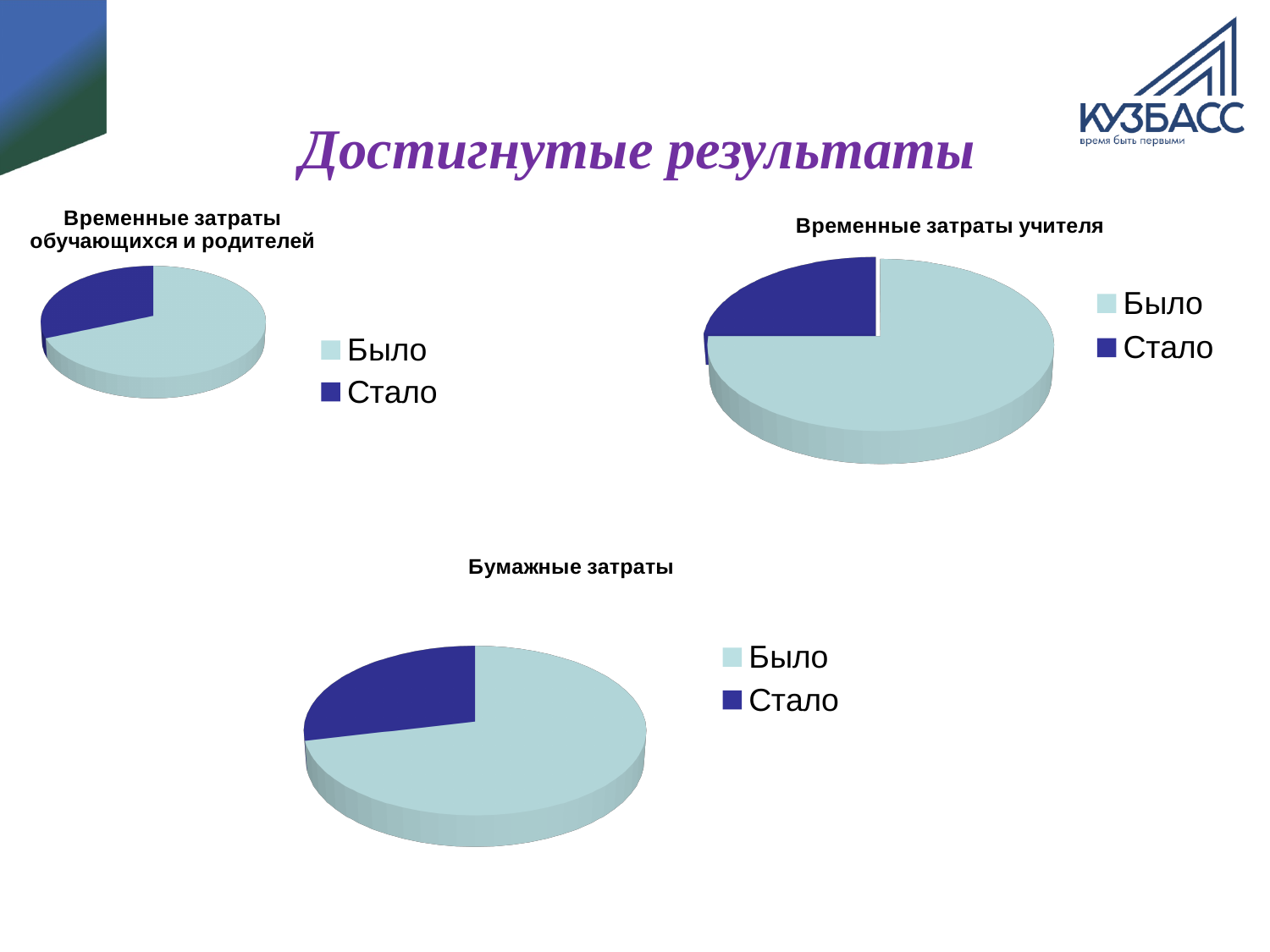
In the chart "Временные затраты обучающихся и родителей", which slice is the largest? Было In the chart "Бумажные затраты", which slice is the smallest? Стало What is the title of the chart at the bottom of the slide? Бумажные затраты How many slices does the pie chart "Бумажные затраты" have? 2 In the chart "Временные затраты учителя", which slice is the smallest? Стало How many charts are on the slide? 3 In the chart "Бумажные затраты", which is larger, Было or Стало? Было How many entries does the legend of "Бумажные затраты" list? 2 What kind of chart is "Временные затраты учителя"? pie chart What colour is the Стало slice in the chart "Временные затраты учителя"? dark blue In the chart "Временные затраты учителя", which is larger, Стало or Было? Было